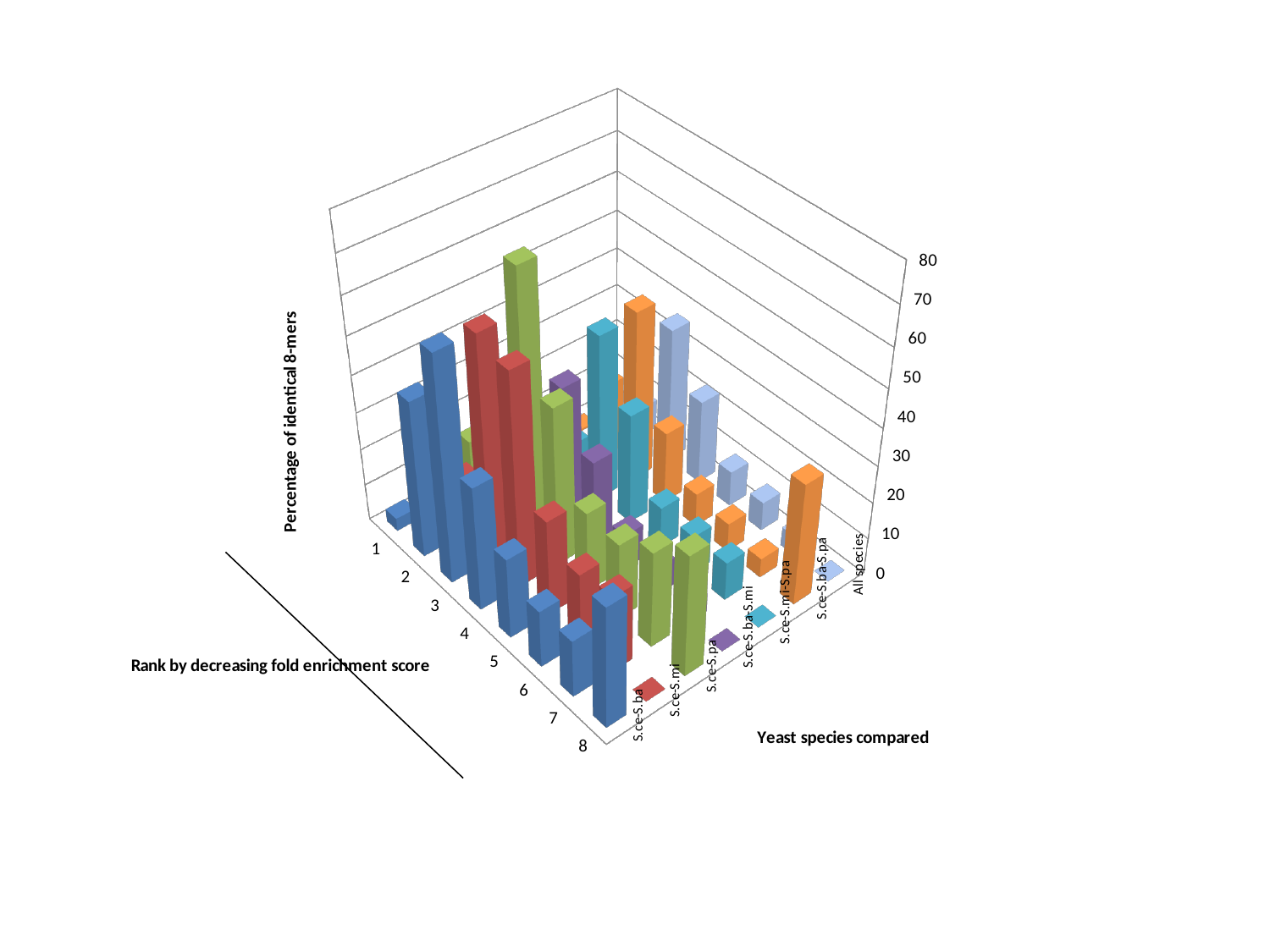
What kind of chart is shown on the slide? 3D bar chart What is the label of the first category on the 'Yeast species compared' axis? S.ce-S.ba What is the label of the last category on the 'Yeast species compared' axis? All species What is the title of the vertical axis? Percentage of identical 8-mers How many rank categories are shown along the 'Rank by decreasing fold enrichment score' axis? 8 What is the highest value shown on the vertical axis? 80 How many yeast species comparison categories are shown along the 'Yeast species compared' axis? 7